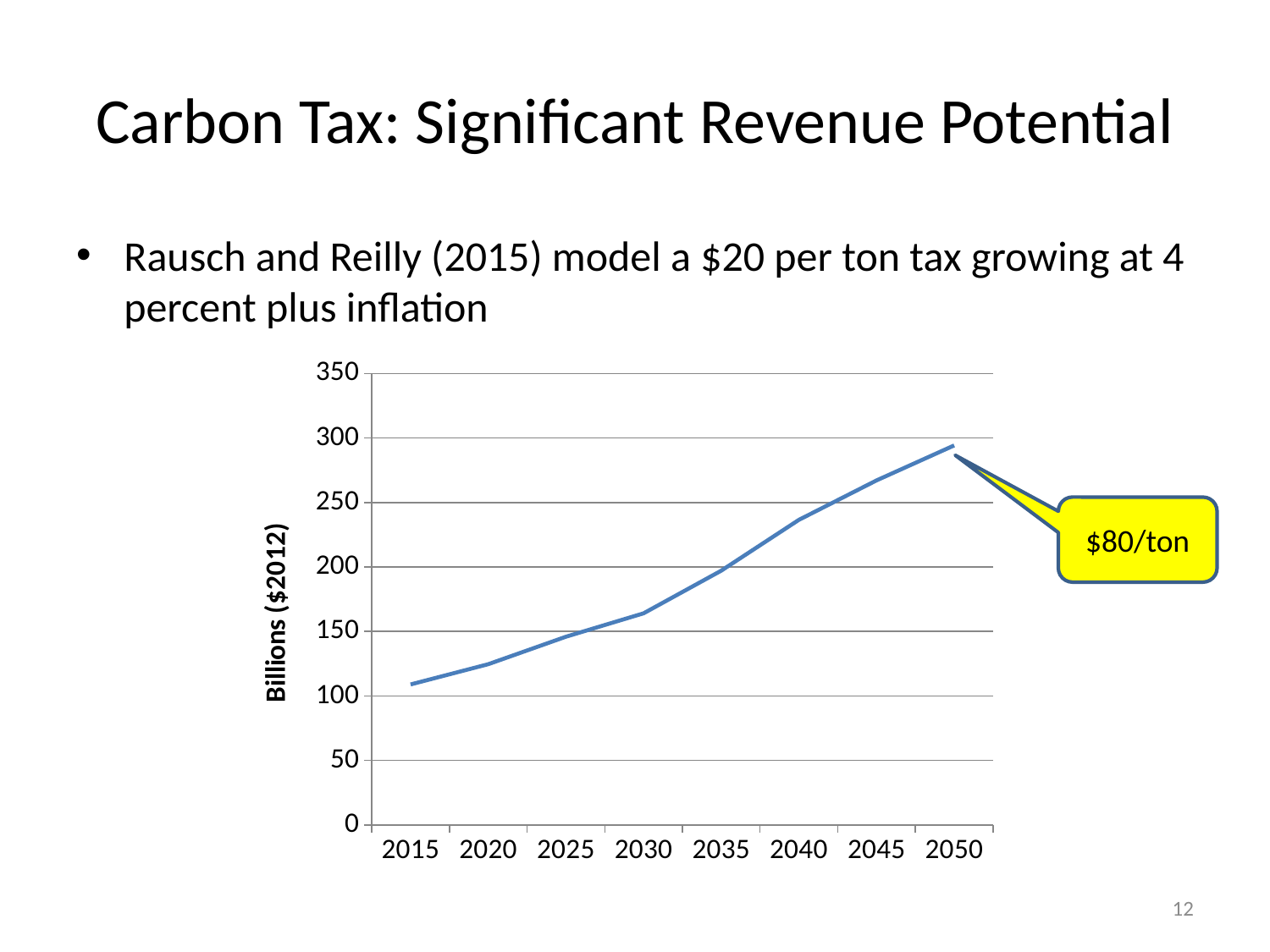
Which year has the lowest value on the chart? 2015 How many years are labelled on the x axis of the chart? 8 What is the label on the vertical axis of the chart? Billions ($2012) Is the value for 2040 greater or less than 300? less Is the value for 2015 greater or less than 150? less Is the value for 2035 greater or less than 150? greater What kind of chart is shown on the slide? line chart Which is larger, the value for 2030 or the value for 2045? 2045 What does the yellow callout pointing at the 2050 end of the line say? $80/ton Which year has the highest value on the chart? 2050 Do the values rise or fall from 2015 to 2050? rise